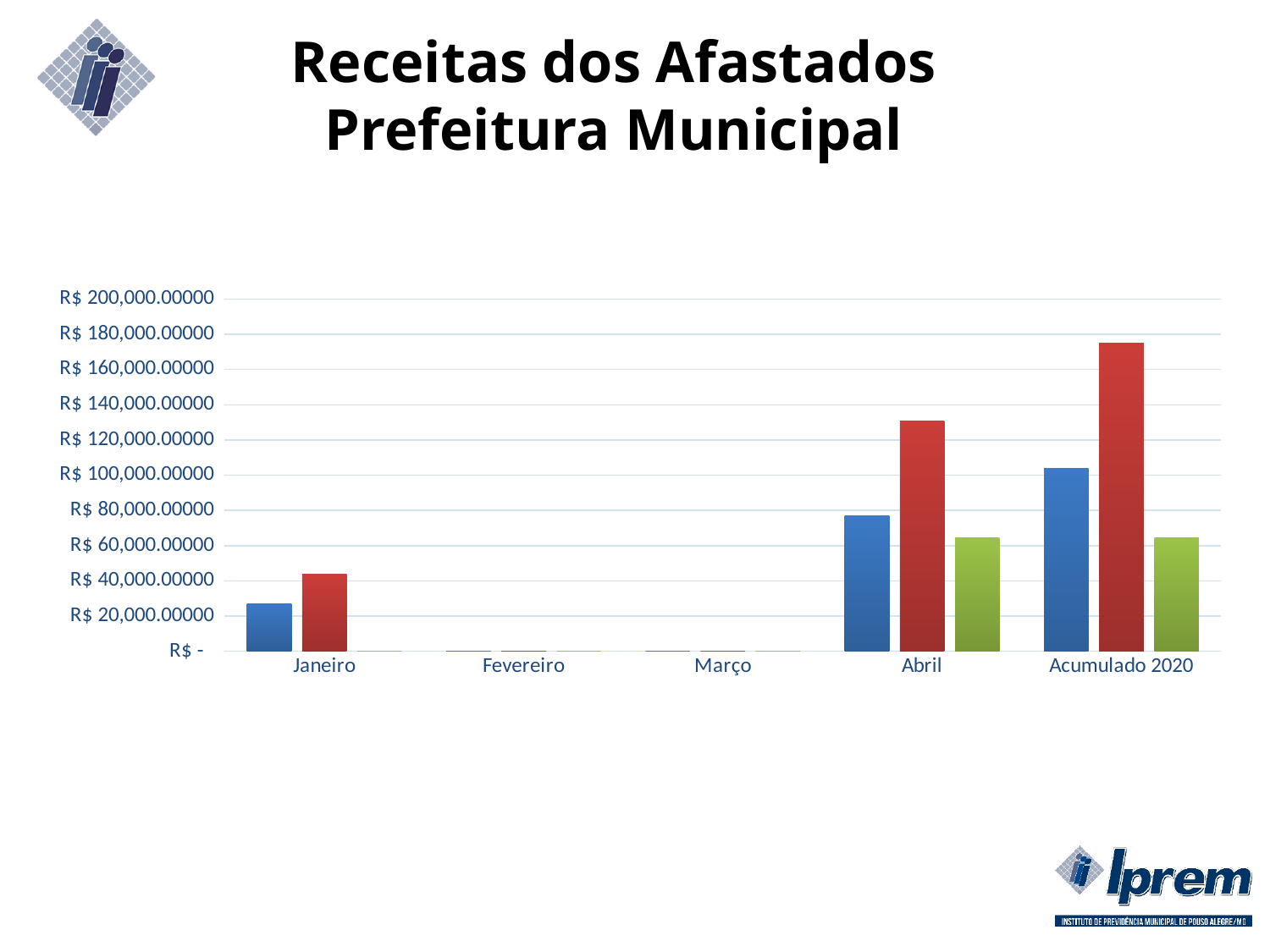
Is the green bar for Abril greater or less than R$ 80,000.00000? less Which is larger, the blue bar for Abril or the blue bar for Acumulado 2020? Acumulado 2020 Which is larger, the red bar for Janeiro or the red bar for Abril? Abril How many differently coloured bar series are plotted in the chart? 3 Is the red bar for Acumulado 2020 greater or less than R$ 160,000.00000? greater What kind of chart is shown on the slide? bar chart Which category has the tallest red bar? Acumulado 2020 Is the red bar for Abril greater or less than R$ 120,000.00000? greater How many categories are shown on the x axis of the chart? 5 What is the title of the slide containing the chart? Receitas dos Afastados Prefeitura Municipal Which category has the tallest bar overall in the chart? Acumulado 2020